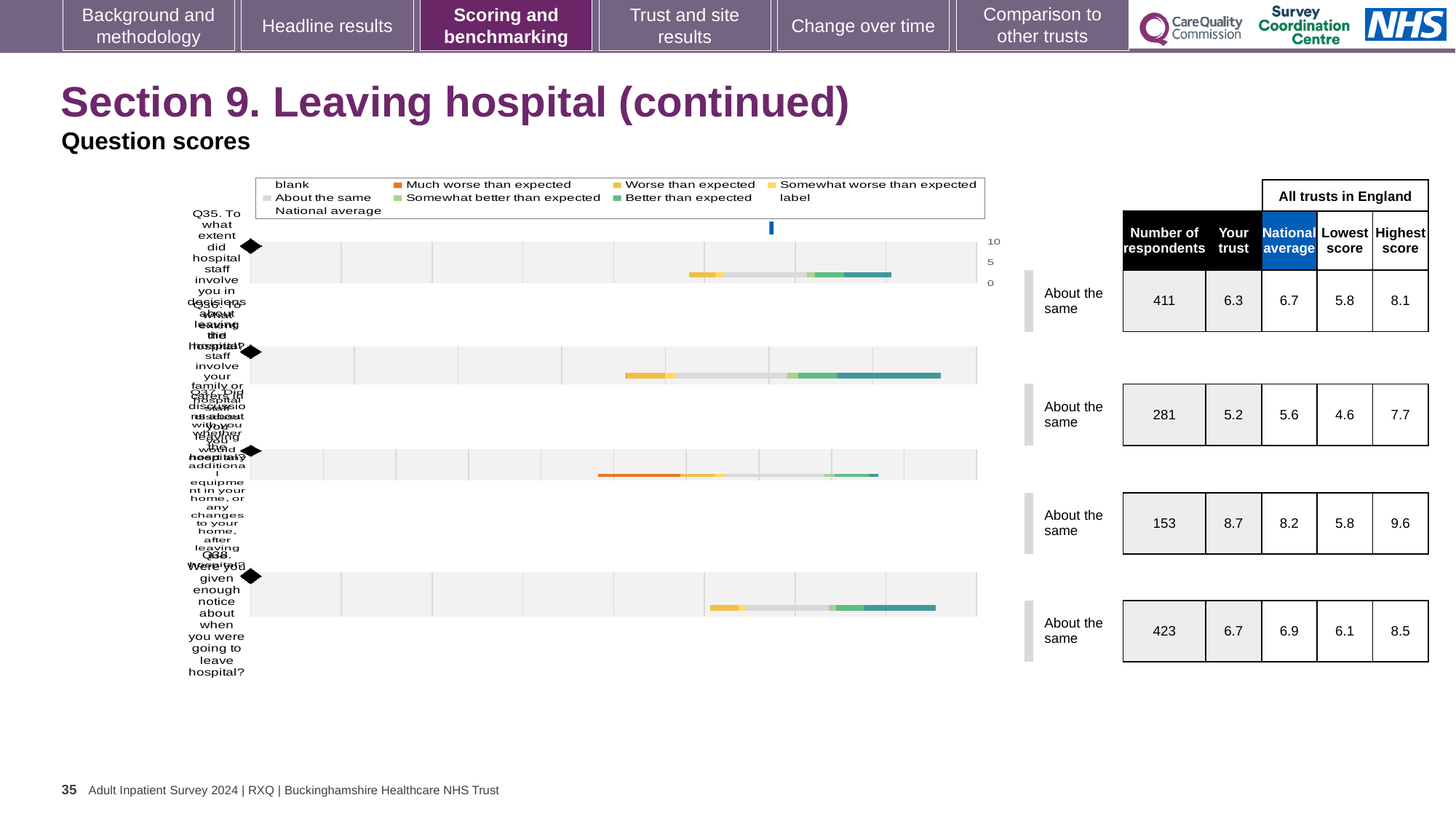
Which legend entry is shown in orange? Much worse than expected What benchmark category is shown next to every question row on the slide? About the same What kind of chart is shown on the slide? Bar chart For the bottom row (Q38), what is the difference between the national average and the 'Your trust' score? 0.2 In the table beside the chart, what is the highest score for the third row? 9.6 In the table beside the chart, what is the 'Your trust' score for the top row (Q35)? 6.3 Which row in the table has the highest 'Your trust' score? The third row (8.7) Which row in the table has the lowest 'Your trust' score? The second row (5.2) In the table beside the chart, what is the lowest score for the second row? 4.6 In the table beside the chart, what is the number of respondents for the bottom row (Q38)? 423 How many question rows (bars) does the chart show? 4 For the top row (Q35), which is larger: the 'Your trust' score or the national average? National average